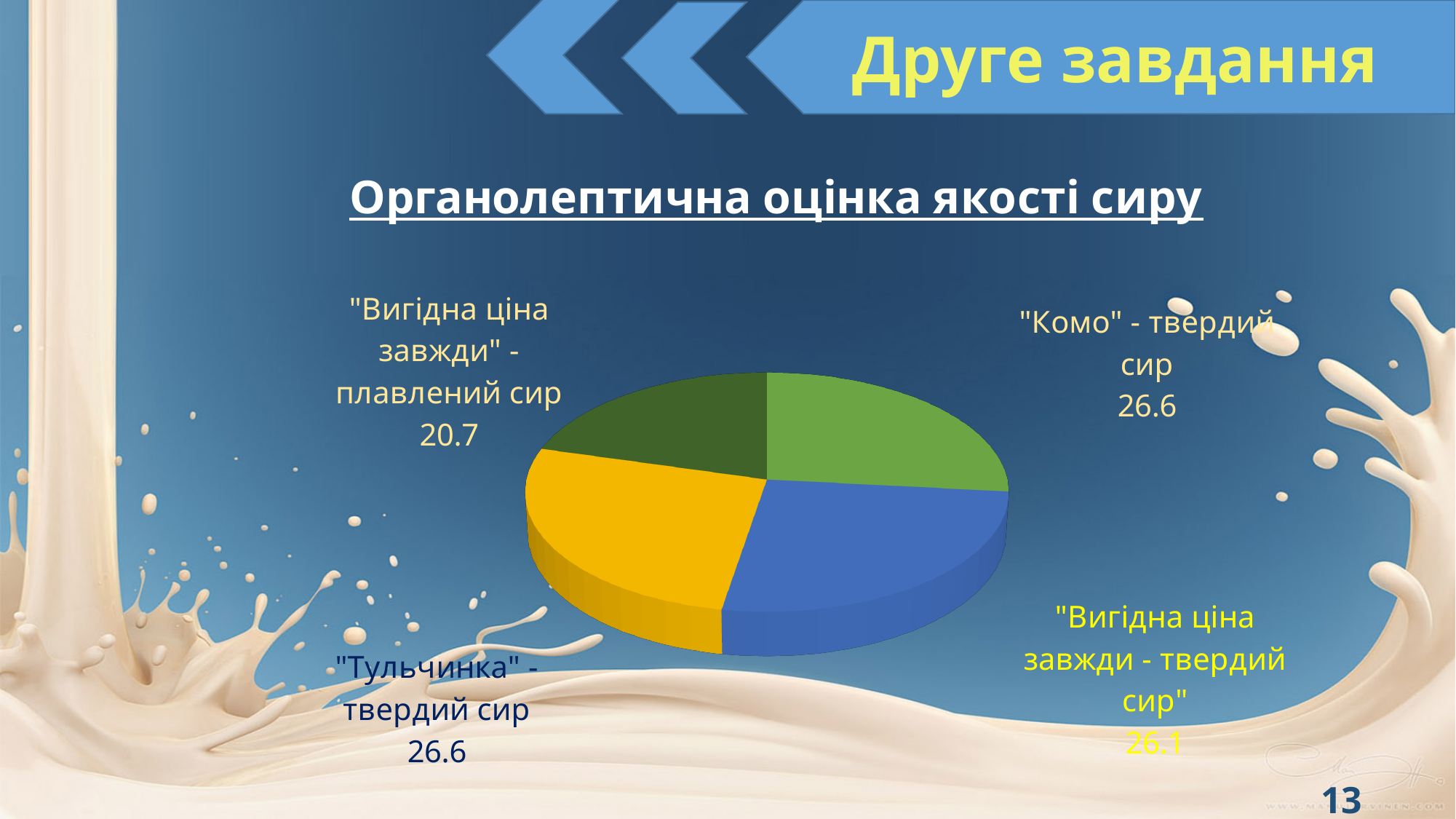
Which category has the lowest value? "Вигідна ціна завжди" - плавлений сир What is the value for "Тульчинка" - твердий сир? 26.6 What is the total of all the values shown in the pie chart? 100.0 What is the value for "Вигідна ціна завжди - твердий сир"? 26.1 Which is larger: the value for "Комо" - твердий сир or for "Вигідна ціна завжди - твердий сир"? "Комо" - твердий сир What is the title of the chart? Органолептична оцінка якості сиру What is the value for "Комо" - твердий сир? 26.6 What share of the pie does "Вигідна ціна завжди" - плавлений сир represent? 20.7% What kind of chart is shown on the slide? Pie chart How many categories are shown in the pie chart? 4 What is the value for "Вигідна ціна завжди" - плавлений сир? 20.7 What is the difference between the values for "Комо" - твердий сир and "Вигідна ціна завжди" - плавлений сир? 5.9